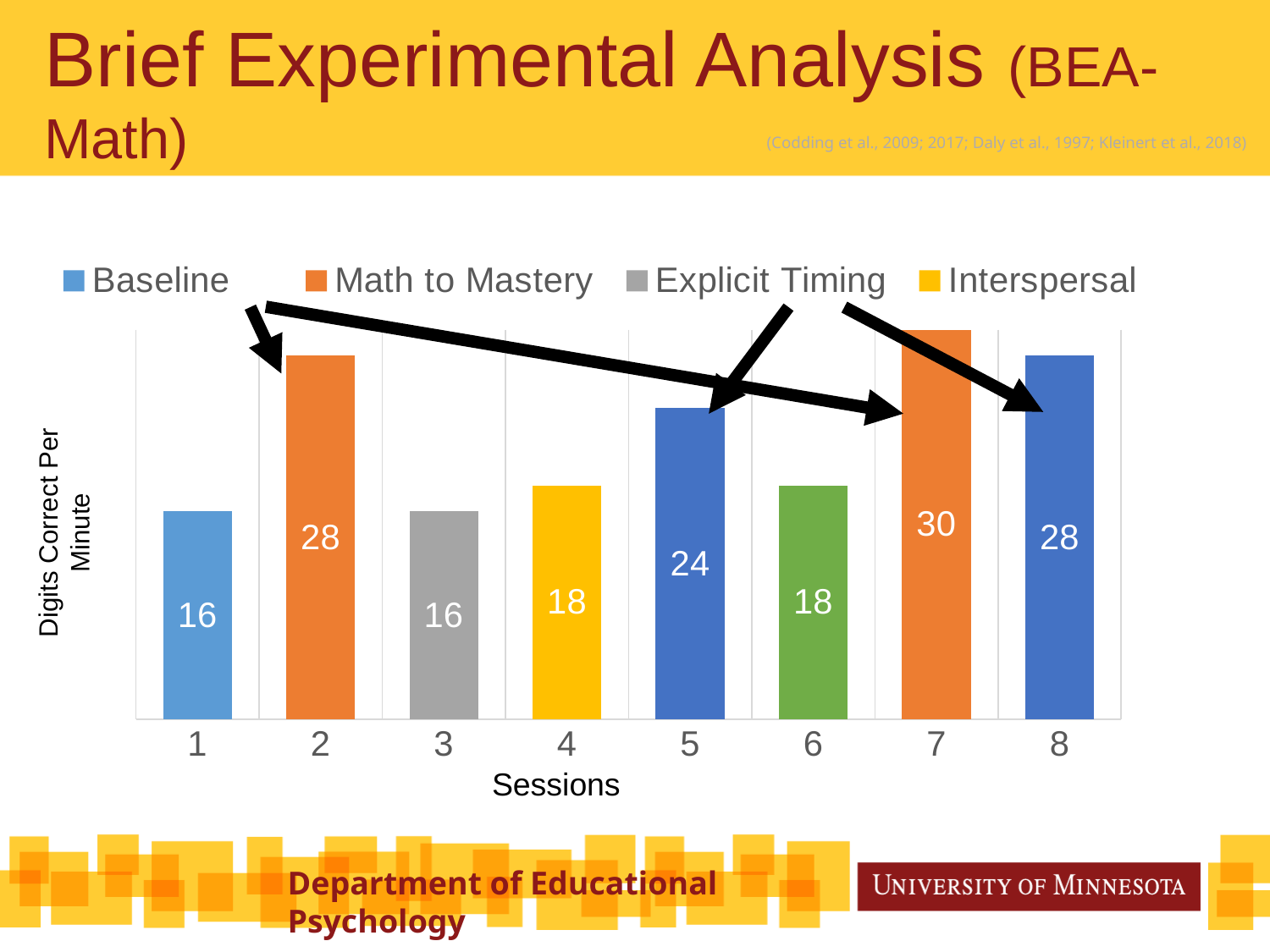
How many series does the legend list? 4 What is the difference between the values for session 2 and session 3? 12 What kind of chart is shown on the slide? bar chart Which session has the highest value? 7 What is the label on the y axis of the chart? Digits Correct Per Minute What is the difference between the values for session 7 and session 1? 14 What is the value for session 5? 24 What is the value for session 7? 30 Which is larger, the value for session 5 or the value for session 6? session 5 What is the value for session 1? 16 How many sessions are shown on the x axis? 8 What is the value for session 4? 18